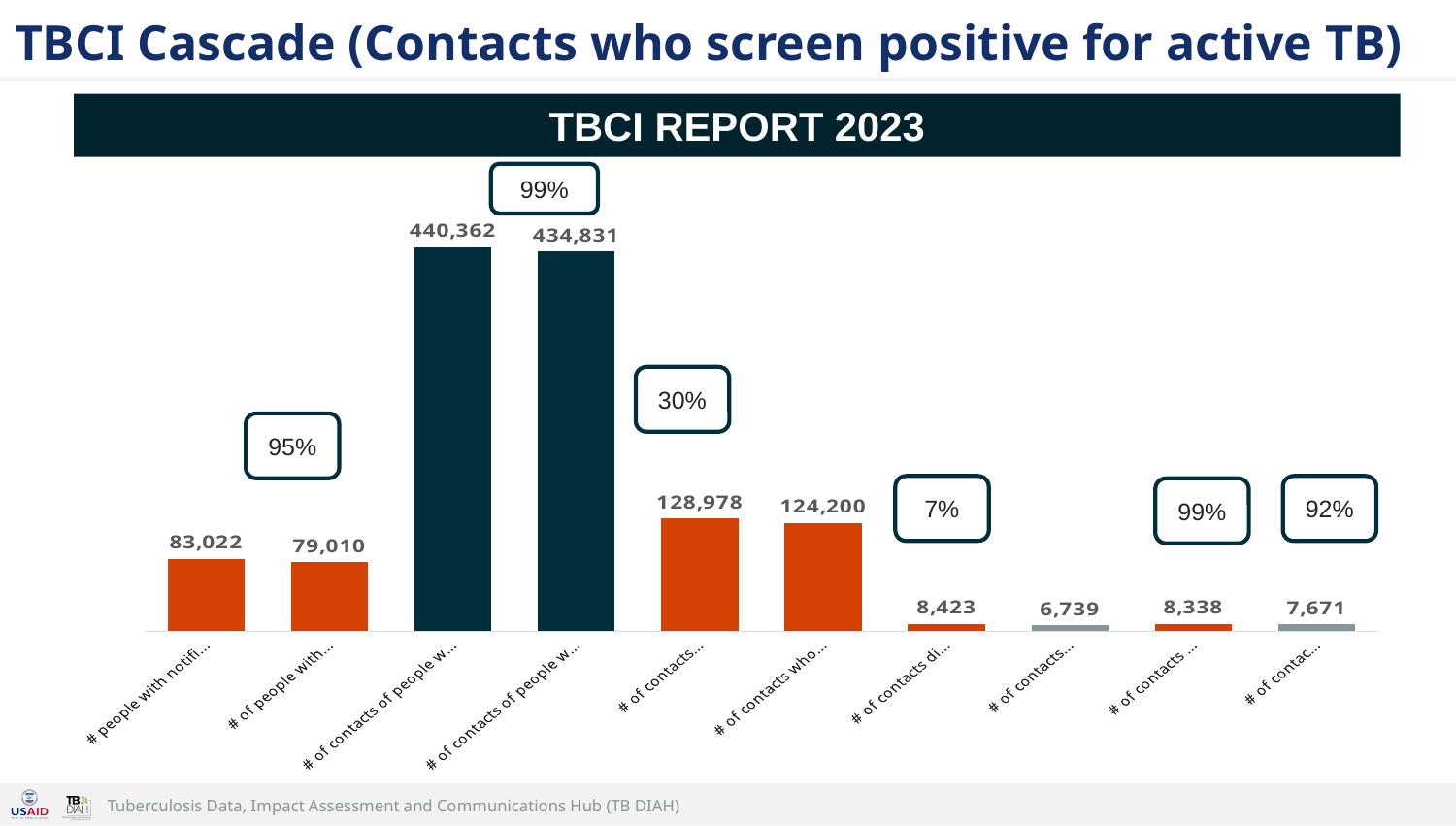
What is the value of the fourth bar from the left in the chart? 434,831 What is the title shown above the chart? TBCI REPORT 2023 What kind of chart is shown on the slide? bar chart Which is larger: the bar labelled 128,978 or the bar labelled 124,200? 128,978 What is the value of the first (leftmost) bar in the chart? 83,022 What is the value of the second bar from the left in the chart? 79,010 What percentage is shown in the box above the bars labelled 128,978 and 124,200? 30% What is the value of the last (rightmost) bar in the chart? 7,671 What is the difference between the third bar (440,362) and the fourth bar (434,831)? 5,531 What is the value of the tallest bar in the chart? 440,362 How many bars are plotted in the chart? 10 What is the value of the shortest bar in the chart? 6,739